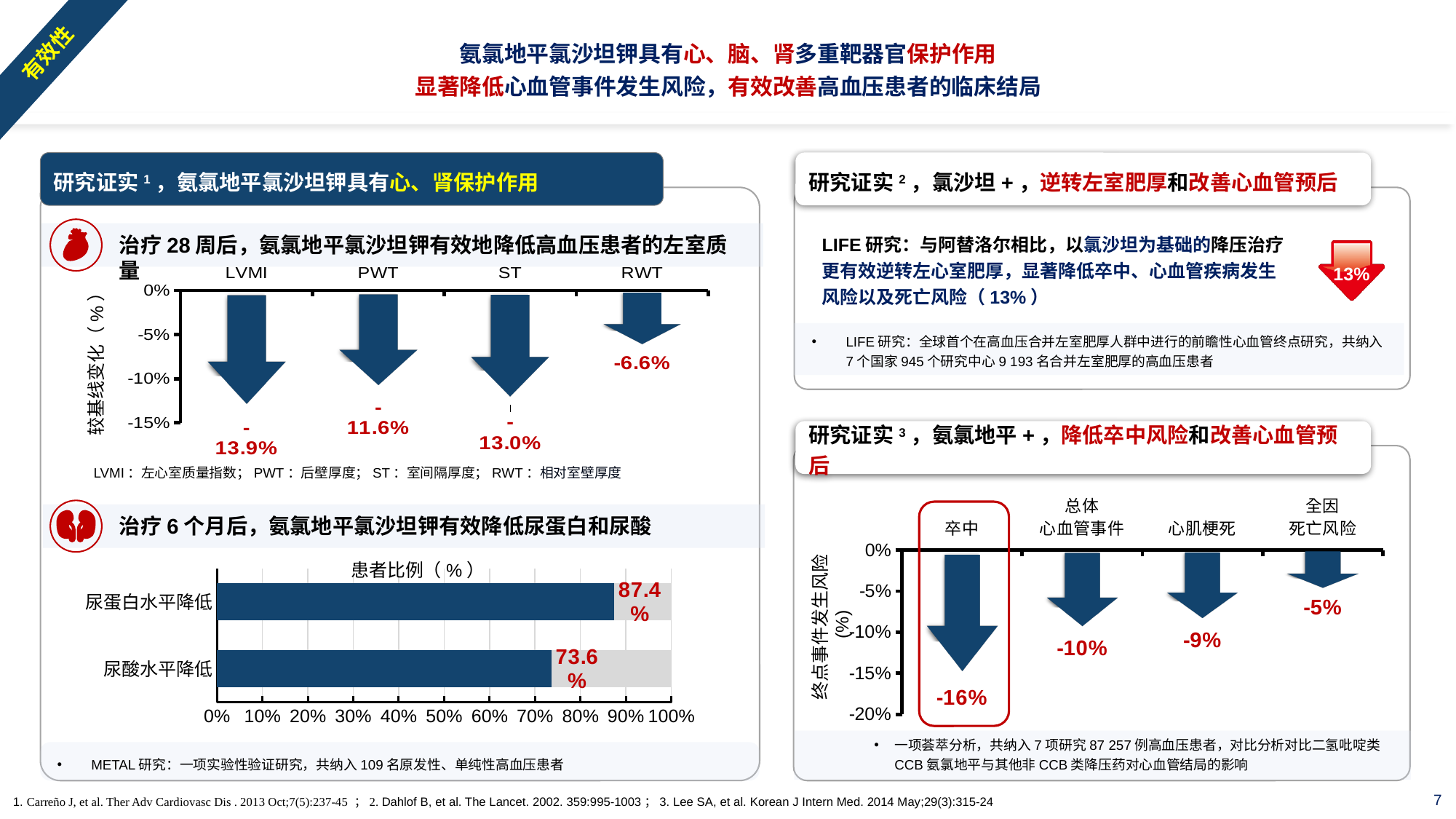
In the bottom-right chart (终点事件发生风险), which category shows the smallest risk reduction? 全因死亡风险 In the bottom-left bar chart (患者比例), what is the value for 尿蛋白水平降低? 87.4% In the top-left chart (较基线变化), which category shows the largest reduction from baseline? LVMI In the top-left chart (较基线变化), what is the value for RWT? -6.6% In the top-left chart (较基线变化), how many categories are plotted? 4 In the bottom-left bar chart (患者比例), what is the difference between 尿蛋白水平降低 and 尿酸水平降低? 13.8% In the bottom-right chart (终点事件发生风险), what is the value for 心肌梗死? -9% In the bottom-left bar chart (患者比例), what is the value for 尿酸水平降低? 73.6% In the top-left chart (较基线变化), which category shows the smallest reduction from baseline? RWT In the bottom-right chart (终点事件发生风险), what is the value for 卒中? -16% In the top-left chart (较基线变化), what is the value for LVMI? -13.9% What kind of chart is the bottom-left chart (患者比例)? bar chart